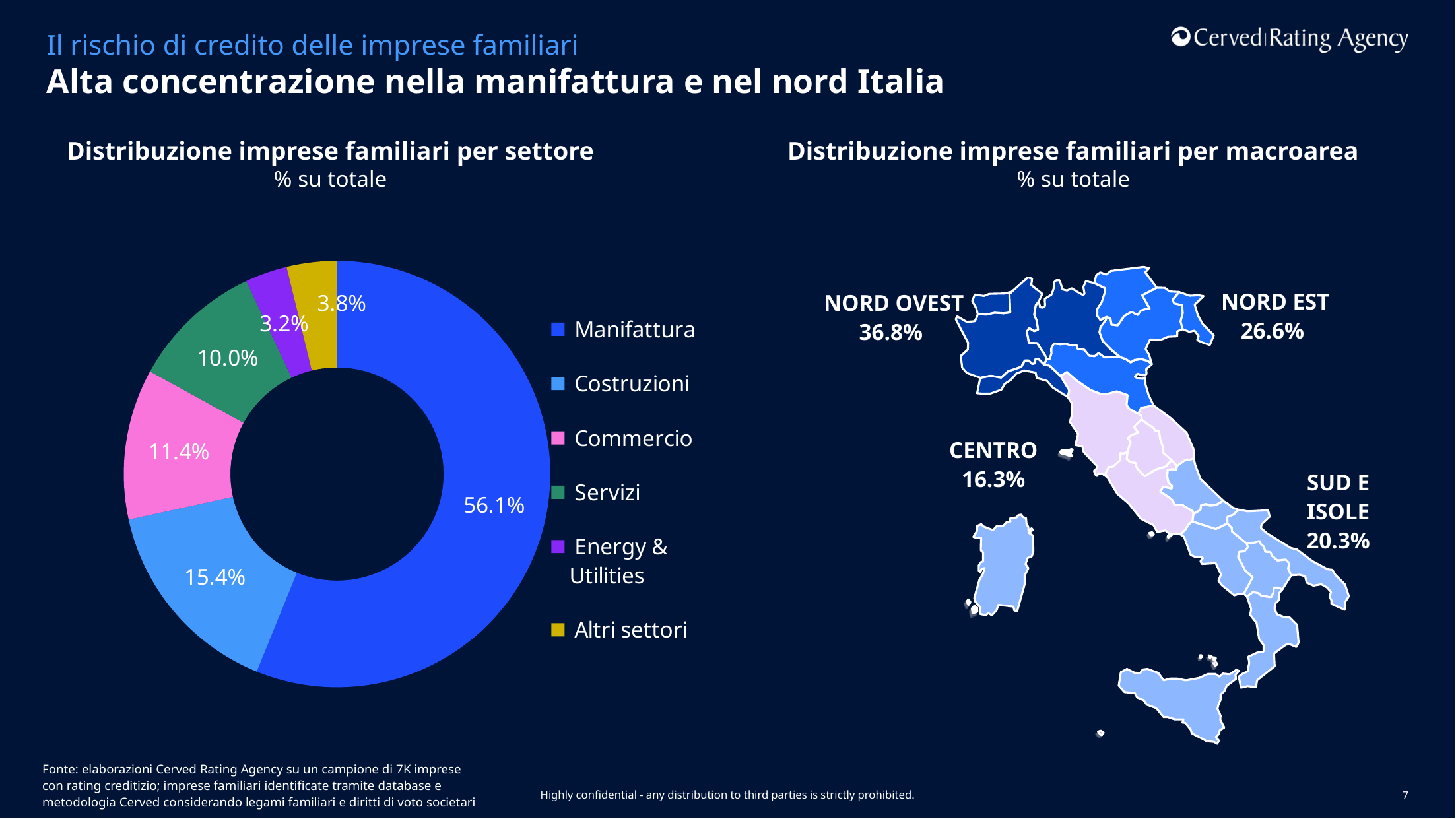
In the chart 'Distribuzione imprese familiari per settore', what is the difference between the shares of Costruzioni and Servizi? 5.4% In the map 'Distribuzione imprese familiari per macroarea', what share is shown for Nord Ovest? 36.8% In the chart 'Distribuzione imprese familiari per settore', what share is shown for Commercio? 11.4% In the chart 'Distribuzione imprese familiari per settore', what colour is the Servizi slice? Green What kind of chart is 'Distribuzione imprese familiari per settore'? Donut (pie) chart In the chart 'Distribuzione imprese familiari per settore', which sector has the largest share? Manifattura In the chart 'Distribuzione imprese familiari per settore', which is larger: Altri settori or Energy & Utilities? Altri settori In the chart 'Distribuzione imprese familiari per settore', what share is shown for Manifattura? 56.1% How many sectors does the legend of the chart 'Distribuzione imprese familiari per settore' list? 6 In the chart 'Distribuzione imprese familiari per settore', which sector has the smallest share? Energy & Utilities In the map 'Distribuzione imprese familiari per macroarea', which macroarea has the lowest share? Centro In the map 'Distribuzione imprese familiari per macroarea', what is the difference between the shares of Nord Est and Sud e Isole? 6.3%